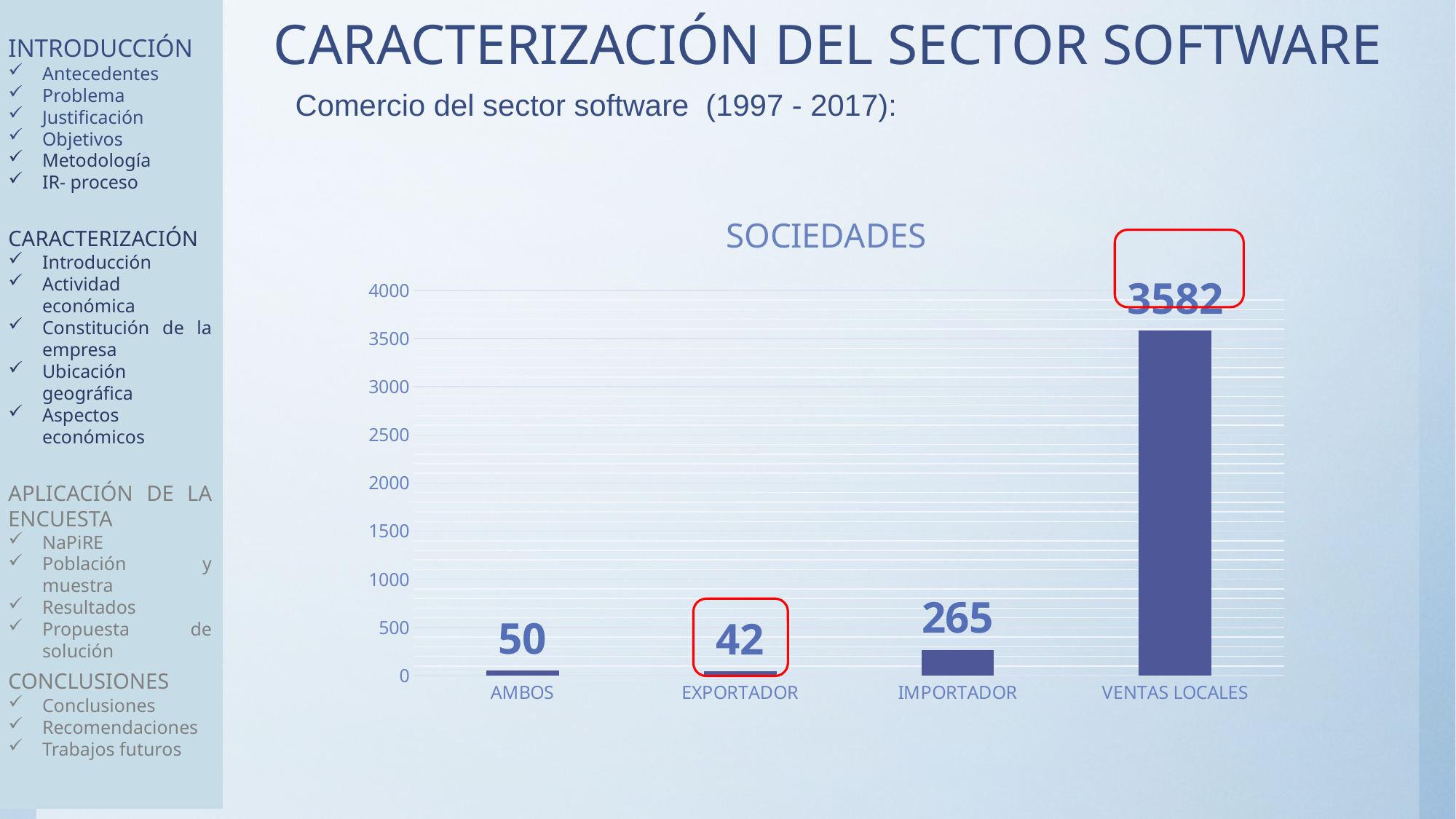
What kind of chart is shown on the slide? bar chart What is the value for AMBOS? 50 How many categories are shown on the x axis? 4 Which is larger, the value for IMPORTADOR or the value for AMBOS? IMPORTADOR What is the value for EXPORTADOR? 42 Which category has the highest value? VENTAS LOCALES What is the difference between the values for VENTAS LOCALES and IMPORTADOR? 3317 What is the value for VENTAS LOCALES? 3582 What is the value for IMPORTADOR? 265 Which category has the lowest value? EXPORTADOR What is the difference between the values for AMBOS and EXPORTADOR? 8 Is the value for VENTAS LOCALES greater or less than 3500? greater